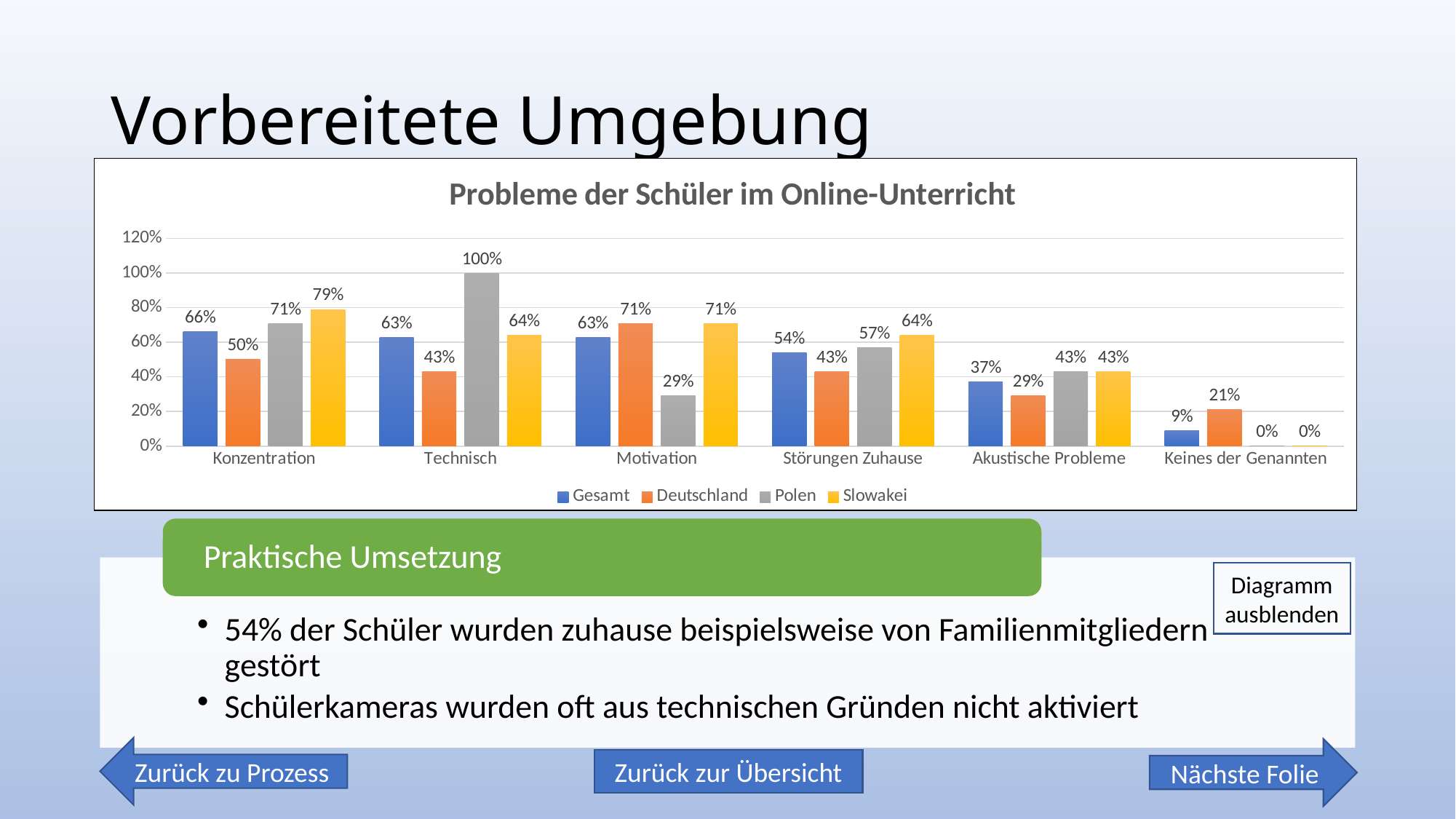
What is the difference between the Slowakei and Deutschland values in the Konzentration category? 29% What is the title of the chart? Probleme der Schüler im Online-Unterricht Which category has the highest value for the Slowakei series? Konzentration In the Motivation category, which is larger: the value for Deutschland or the value for Polen? Deutschland What is the value for Polen in the Technisch category? 100% What kind of chart is shown on the slide? bar chart Is the value for Gesamt in the Akustische Probleme category greater or less than 40%? less What is the value for Gesamt in the Störungen Zuhause category? 54% How many categories are shown on the x axis? 6 Which category has the lowest value for the Gesamt series? Keines der Genannten What is the value for Deutschland in the Keines der Genannten category? 21% How many series does the legend list? 4